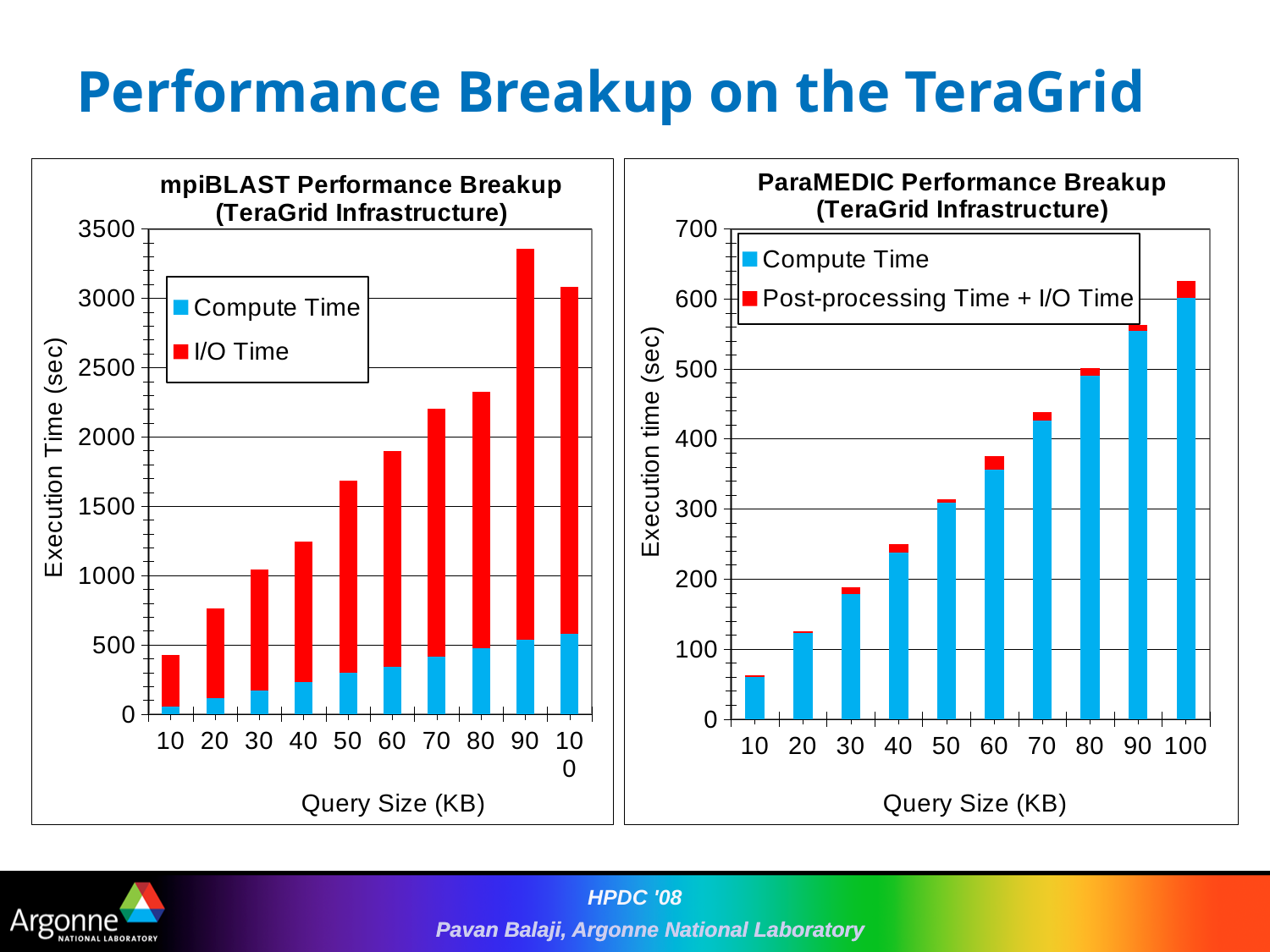
What type of chart is the mpiBLAST Performance Breakup chart on the left? stacked bar chart In the ParaMEDIC Performance Breakup chart, is the total execution time for query size 60 greater or less than 300? greater In the mpiBLAST Performance Breakup chart, which has the larger total execution time: query size 90 or query size 100? 90 In the ParaMEDIC Performance Breakup chart, which query size has the highest total execution time? 100 In the ParaMEDIC Performance Breakup chart, which query size has the lowest total execution time? 10 In the mpiBLAST Performance Breakup chart, which query size has the highest total execution time? 90 How many query sizes are plotted on the x axis of the ParaMEDIC Performance Breakup chart? 10 What are the two legend entries in the mpiBLAST Performance Breakup chart? Compute Time and I/O Time How many series does the legend of the ParaMEDIC Performance Breakup chart list? 2 In the ParaMEDIC Performance Breakup chart, does the total execution time rise or fall as query size increases? rise In the mpiBLAST Performance Breakup chart, is the total execution time for query size 90 greater or less than 3000? greater In the ParaMEDIC Performance Breakup chart, is the total execution time for query size 10 greater or less than 100? less